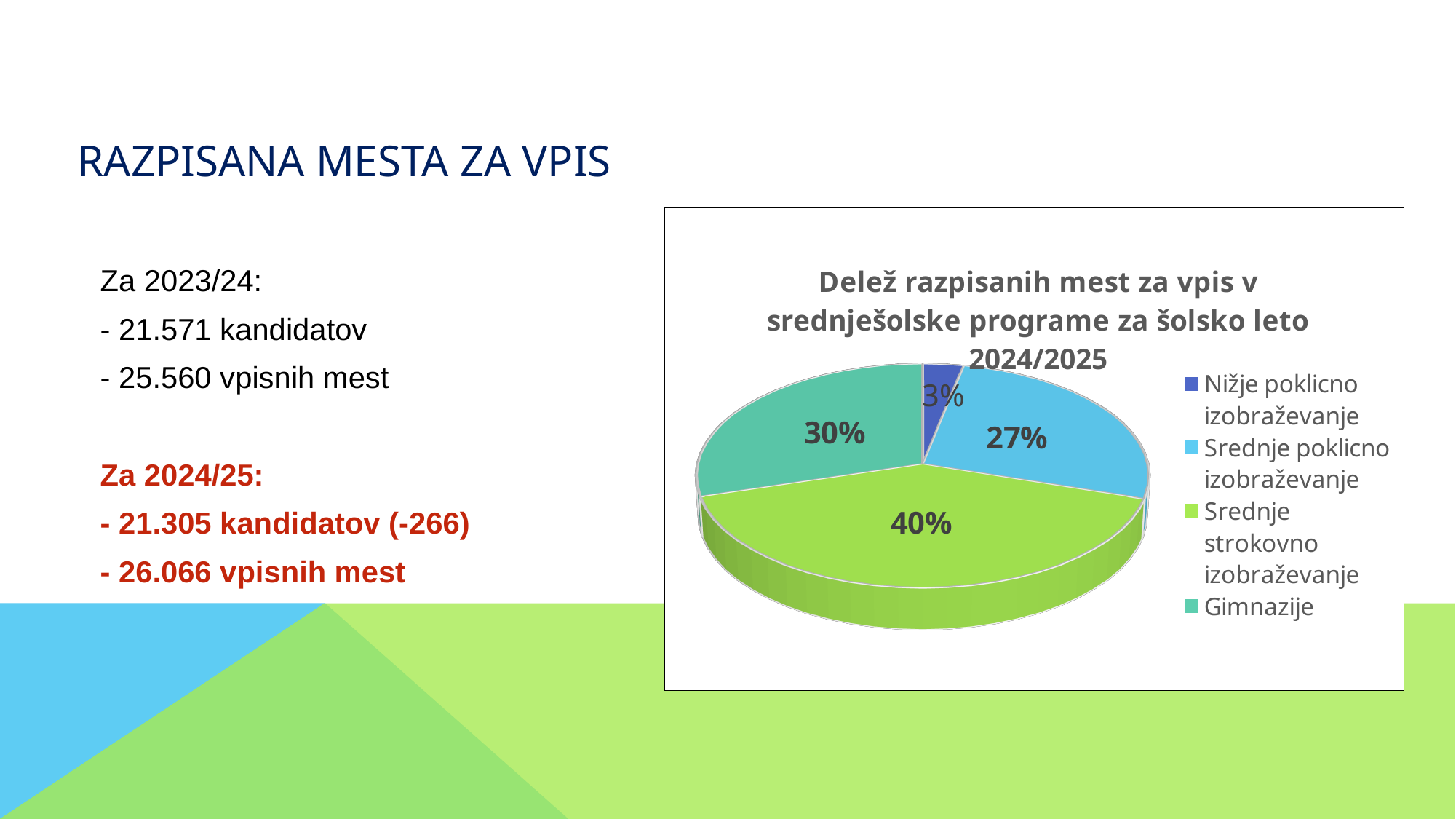
What is the difference in percentage points between the shares of Srednje strokovno izobraževanje and Gimnazije? 10 What share of the pie does Nižje poklicno izobraževanje have? 3% Which category has the smallest share of the pie? Nižje poklicno izobraževanje Which has a larger share, Gimnazije or Srednje poklicno izobraževanje? Gimnazije Which colour represents Gimnazije in the pie chart? teal What share of the pie does Gimnazije have? 30% What share of the pie does Srednje strokovno izobraževanje have? 40% How many slices does the pie chart have? 4 What kind of chart is shown on the slide? pie chart Which category has the largest share of the pie? Srednje strokovno izobraževanje What is the title of the pie chart? Delež razpisanih mest za vpis v srednješolske programe za šolsko leto 2024/2025